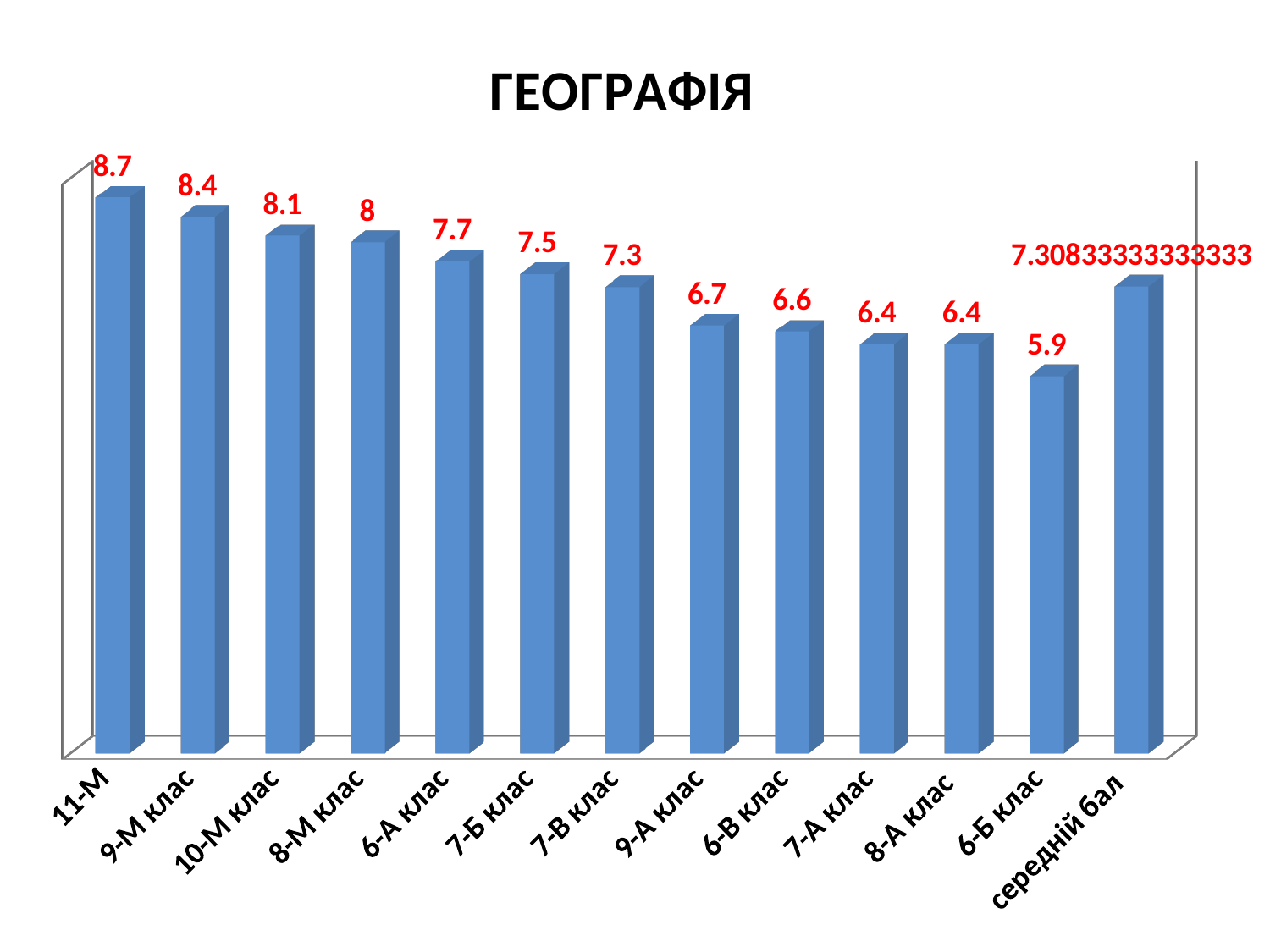
Which category has the lowest value? 6-Б клас What is the value for 11-М? 8.7 What is the value for 7-В клас? 7.3 What is the title of the chart? ГЕОГРАФІЯ What is the difference between the values for 9-М клас and 9-А клас? 1.7 What is the value for 6-Б клас? 5.9 Which class has the highest value? 11-М What kind of chart is shown on the slide? bar chart Do the values rise or fall from 11-М to 6-Б клас along the x axis? fall What value is shown for середній бал? 7.30833333333333 How many bars are plotted in the chart? 13 Which is larger, the value for 8-М клас or the value for 6-В клас? 8-М клас